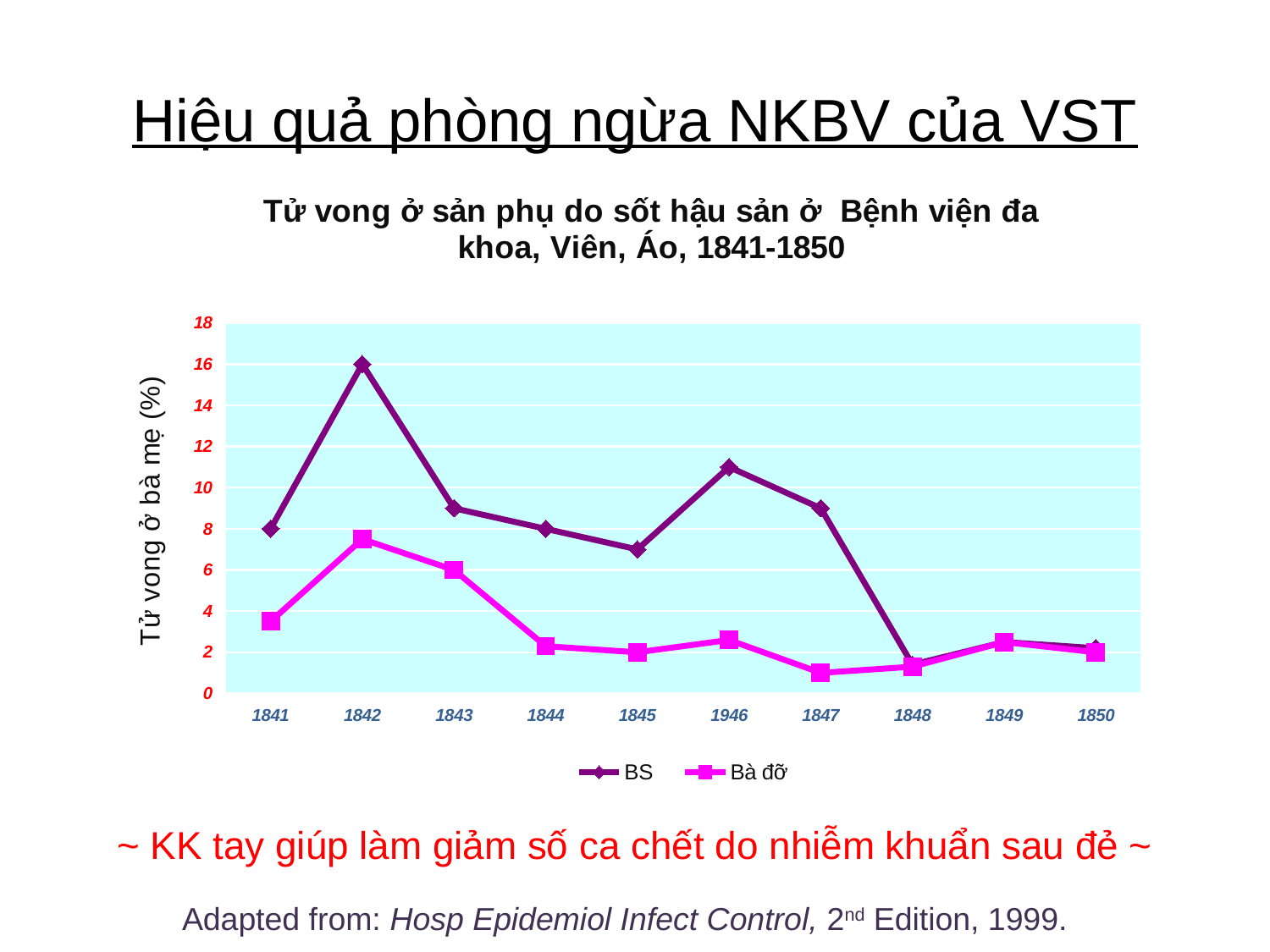
In which year is the BS series highest? 1842 Which series has the larger value in 1845, BS or Bà đỡ? BS How many series does the legend list? 2 What is the value for BS in 1842? 16 Is the value for BS in 1946 greater or less than 10? greater How many years are shown on the x axis? 10 Does the BS series rise or fall from 1847 to 1848? fall Is the value for Bà đỡ in 1847 greater or less than 2? less In which year is the Bà đỡ series highest? 1842 What kind of chart is shown on the slide? line chart What is the value for Bà đỡ in 1843? 6 What is the value for BS in 1841? 8